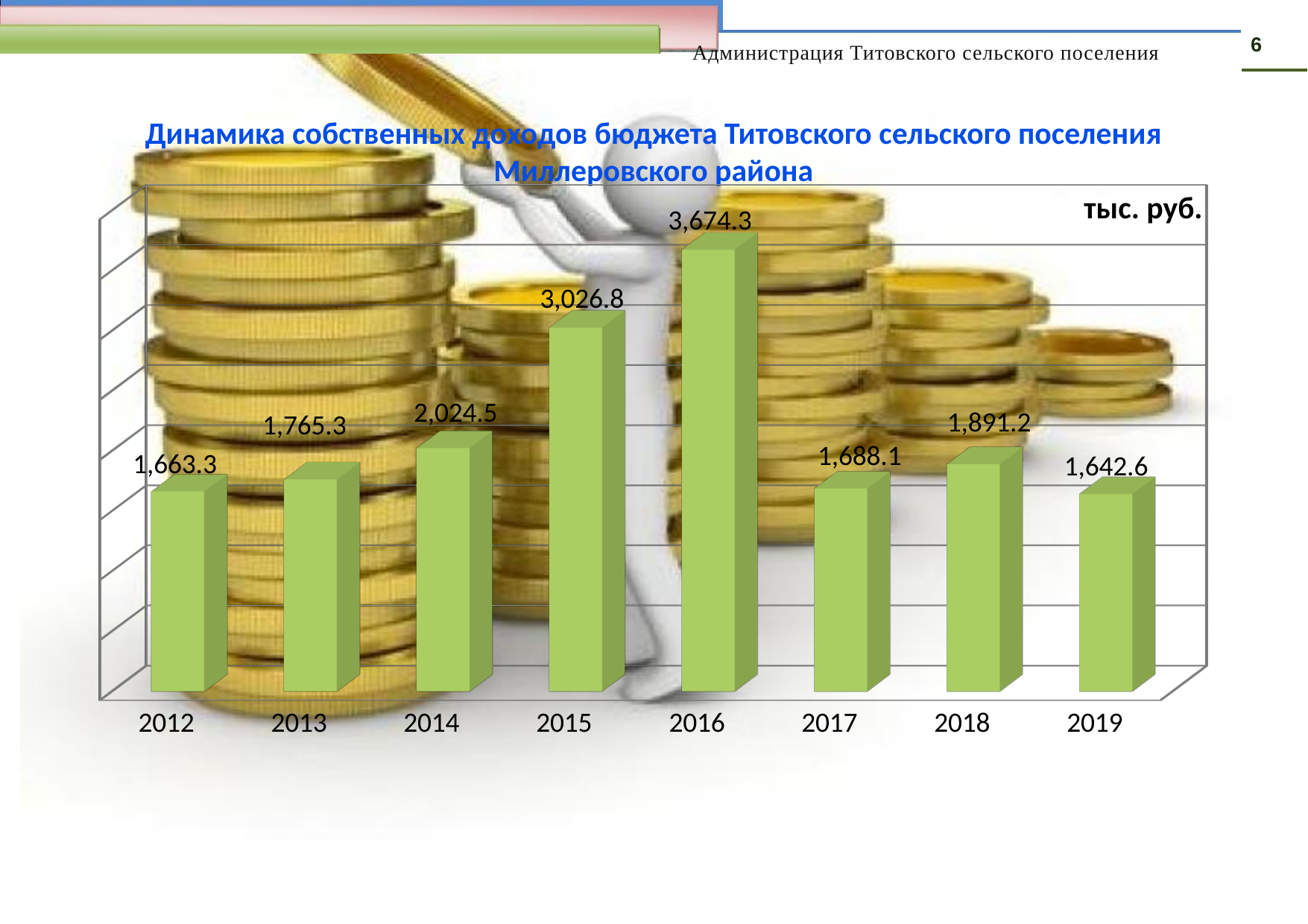
Which year has the lowest value? 2019 From 2012 to 2016, do the values rise or fall? rise What is the value for 2018? 1,891.2 What unit is indicated in the top right corner of the chart? тыс. руб. Which is larger, the value for 2017 or the value for 2018? 2018 What is the difference between the values for 2016 and 2015? 647.5 What is the value for 2012? 1,663.3 What kind of chart is shown on the slide? bar chart What is the value for 2016? 3,674.3 What is the difference between the values for 2014 and 2013? 259.2 Which year has the highest value? 2016 How many years are shown on the x axis? 8